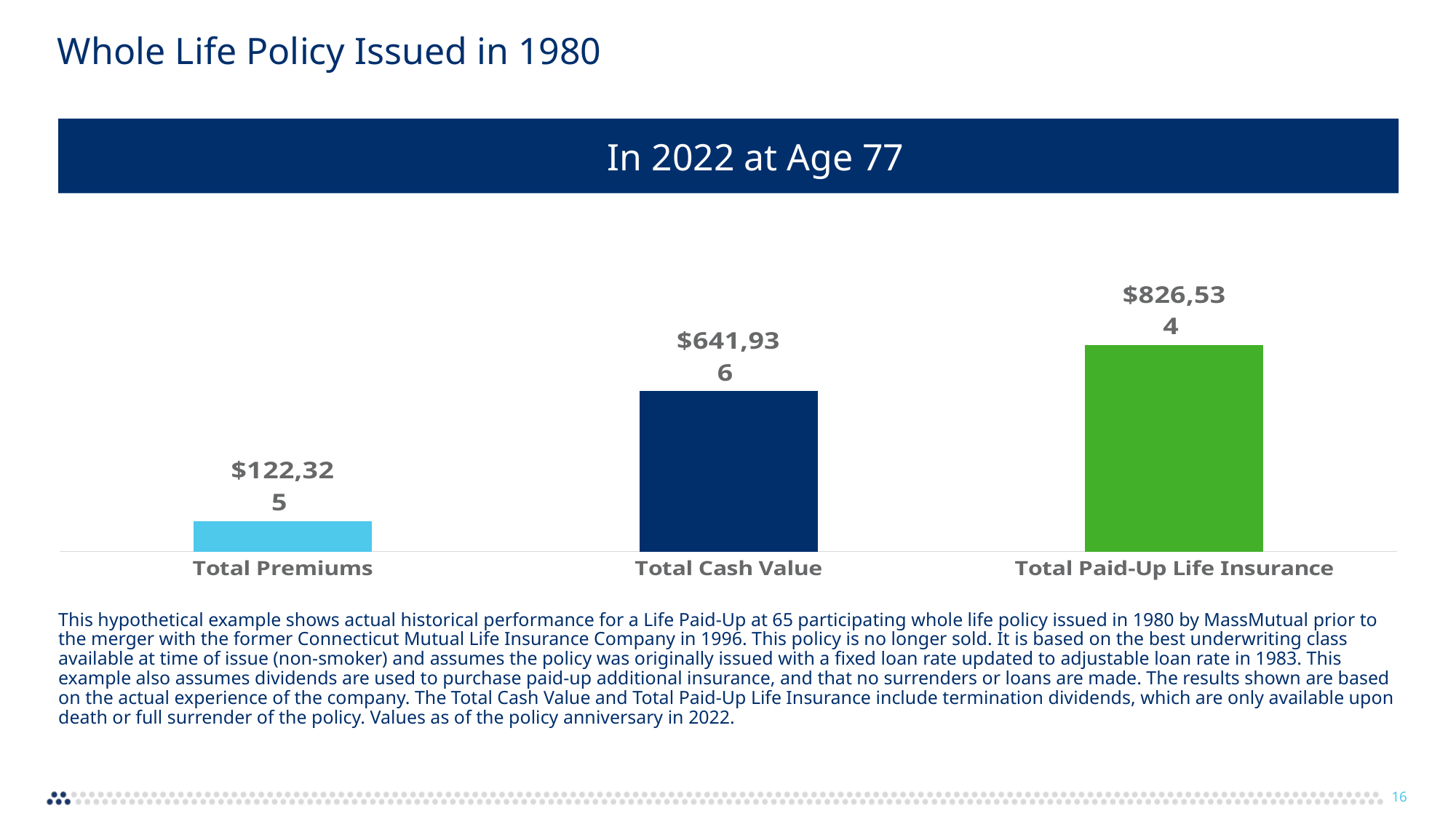
What is the difference between Total Cash Value and Total Premiums? $519,611 What is the value shown for Total Premiums? $122,325 What is the value shown for Total Cash Value? $641,936 Which category has the highest value? Total Paid-Up Life Insurance What colour is the bar for Total Paid-Up Life Insurance? Green What is the value shown for Total Paid-Up Life Insurance? $826,534 What kind of chart is shown on the slide? Bar chart Which category has the lowest value? Total Premiums Which is larger, Total Cash Value or Total Premiums? Total Cash Value What is the difference between Total Paid-Up Life Insurance and Total Cash Value? $184,598 How many categories are plotted in the chart? 3 Do the values rise or fall from left to right across the categories? Rise